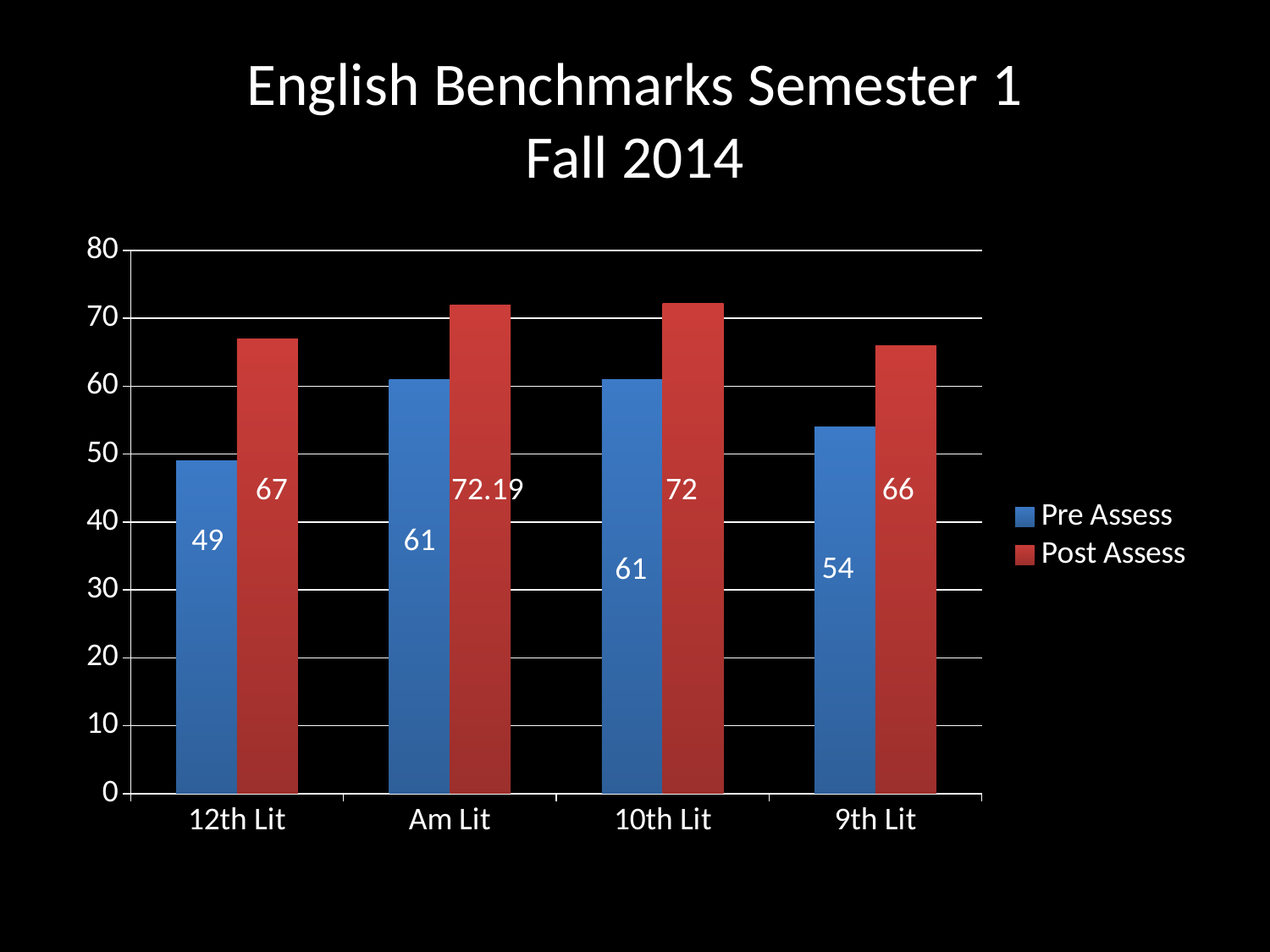
What is the Post Assess value for 9th Lit? 66 What is the difference between the Post Assess and Pre Assess values for 9th Lit? 12 How many categories are shown on the x axis? 4 Which category has the lowest Pre Assess value? 12th Lit What is the difference between the Post Assess and Pre Assess values for 12th Lit? 18 How many series does the legend list? 2 What is the Pre Assess value for 12th Lit? 49 Which category has the lowest Post Assess value? 9th Lit Which is larger, the Pre Assess value for 9th Lit or the Pre Assess value for 12th Lit? 9th Lit What kind of chart is shown on the slide? Bar chart What is the Post Assess value for Am Lit? 72.19 What is the title of the chart? English Benchmarks Semester 1 Fall 2014